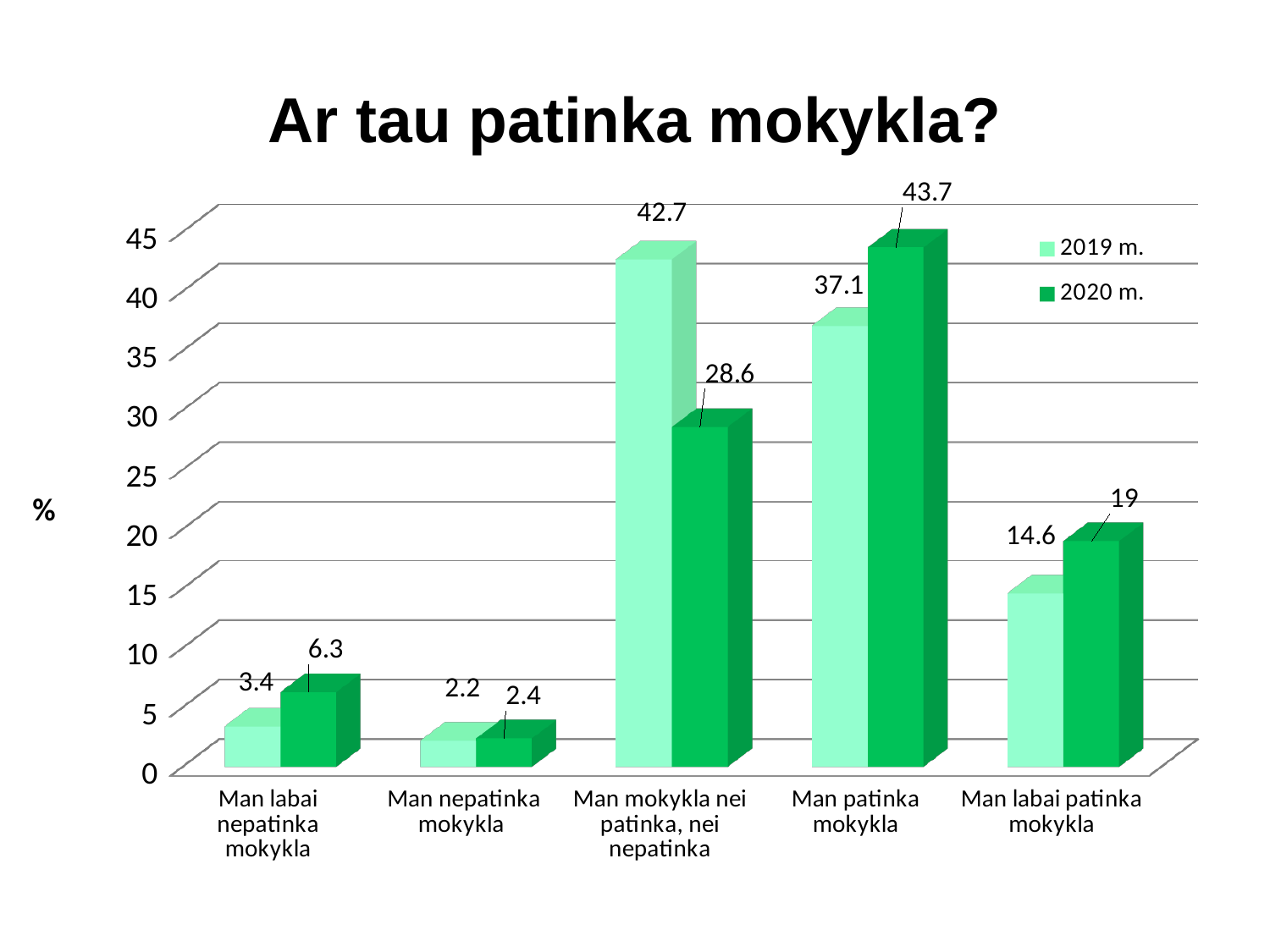
Which category has the highest value in the 2020 m. series? Man patinka mokykla How many categories are shown on the x axis? 5 What kind of chart is shown on the slide? Bar chart What is the title of the chart? Ar tau patinka mokykla? What is the difference between the 2019 m. and 2020 m. values for "Man mokykla nei patinka, nei nepatinka"? 14.1 What is the difference between the 2020 m. and 2019 m. values for "Man labai patinka mokykla"? 4.4 What is the value for "Man patinka mokykla" in the 2020 m. series? 43.7 Which is larger for "Man labai nepatinka mokykla": the 2019 m. value or the 2020 m. value? 2020 m. What is the value for "Man labai patinka mokykla" in the 2019 m. series? 14.6 How many series does the legend list? 2 Which category has the lowest value in the 2019 m. series? Man nepatinka mokykla What is the value for "Man mokykla nei patinka, nei nepatinka" in the 2019 m. series? 42.7